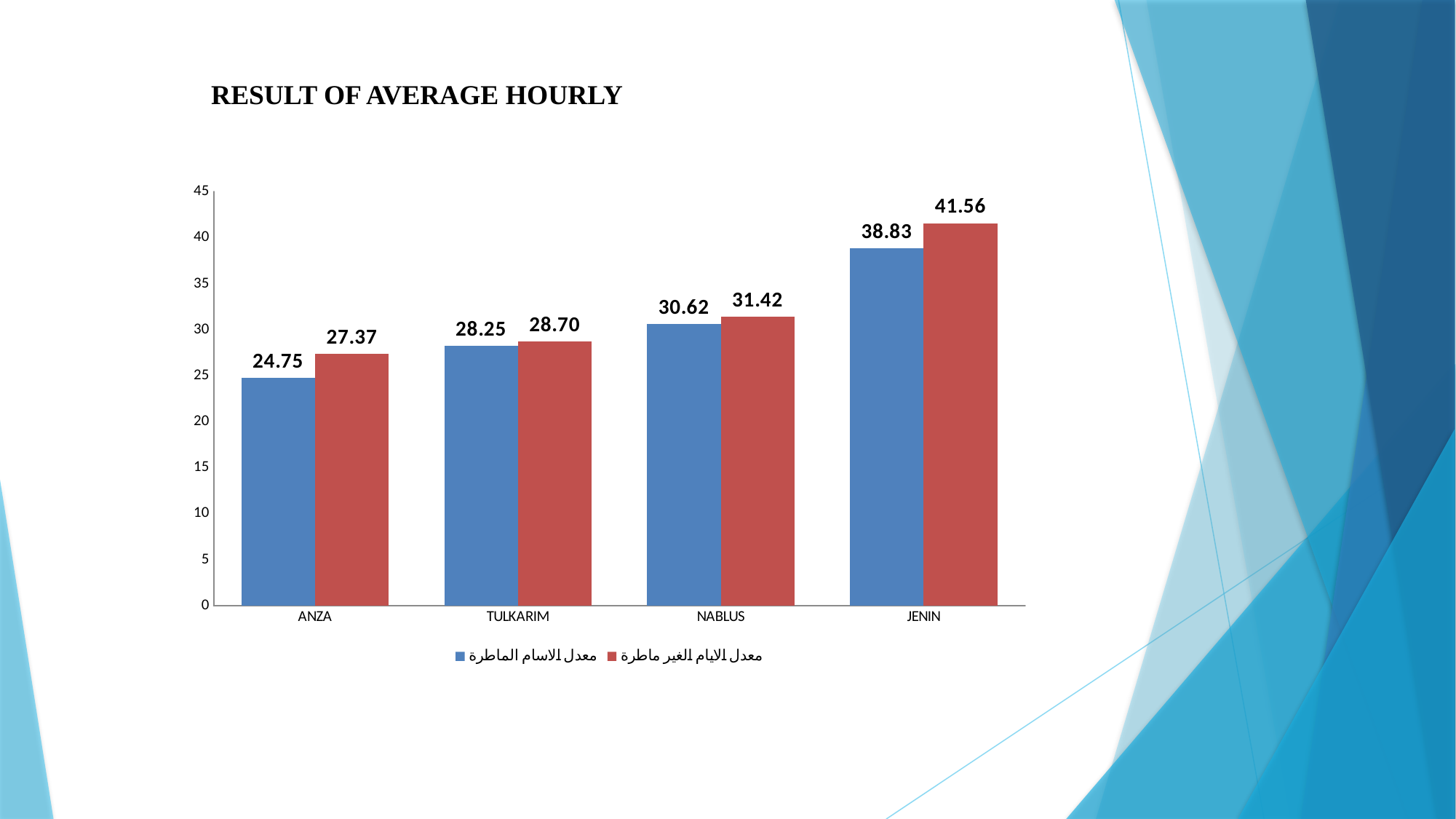
How many categories are shown on the x axis? 4 What kind of chart is shown on the slide? bar chart Is the blue bar for JENIN greater or less than 35? greater What is the value of the red bar for TULKARIM? 28.70 What is the difference between the red and blue bars for JENIN? 2.73 Which category has the highest red bar? JENIN What is the value of the blue bar for ANZA? 24.75 For NABLUS, which bar is larger, the blue or the red? red What is the value of the red bar for JENIN? 41.56 Which category has the lowest blue bar? ANZA How many series does the legend list? 2 What is the difference between the red and blue bars for ANZA? 2.62